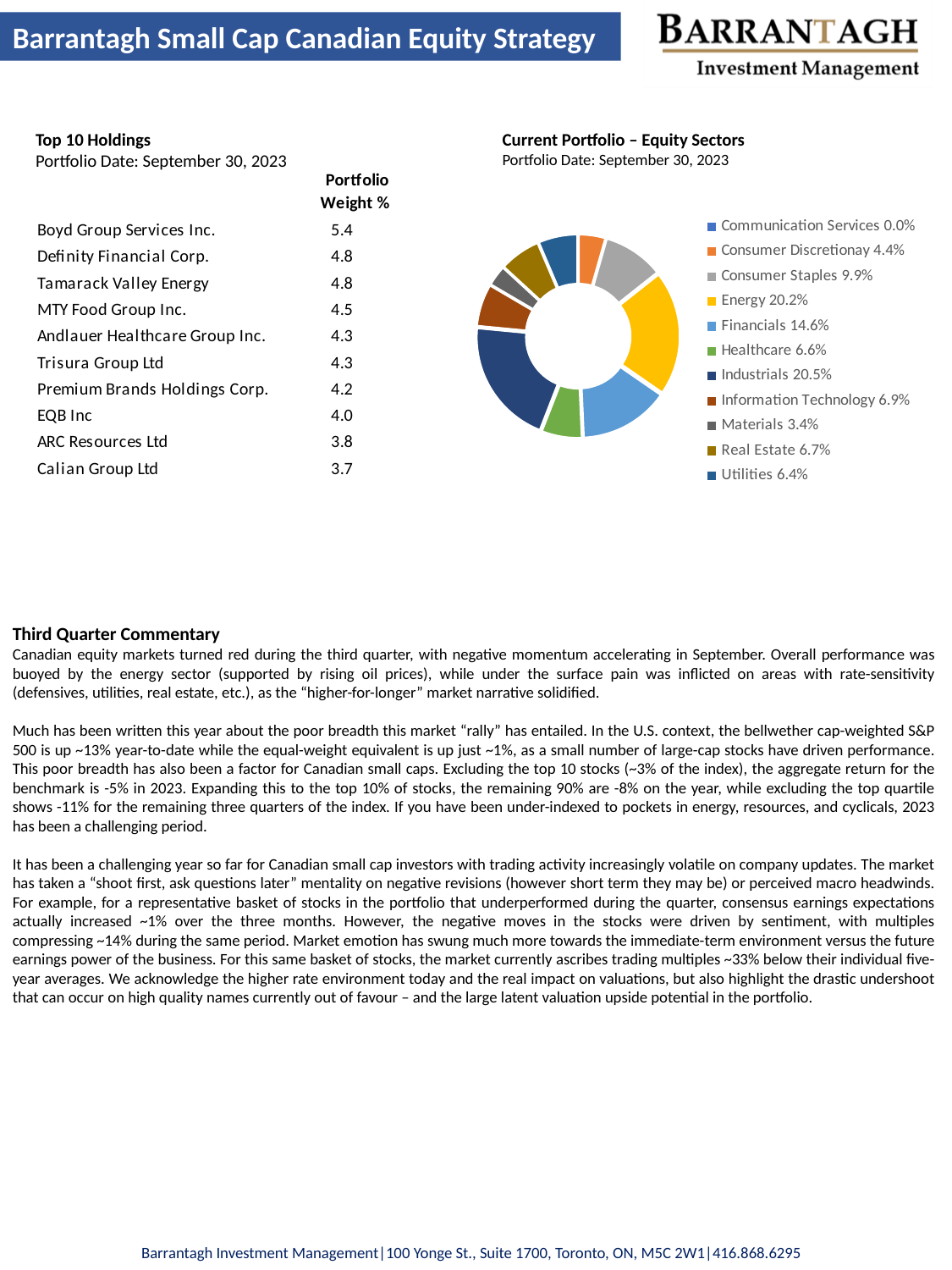
In the 'Current Portfolio – Equity Sectors' chart, what is the share for Energy? 20.2% In the 'Current Portfolio – Equity Sectors' chart, what is the share for Materials? 3.4% In the 'Current Portfolio – Equity Sectors' chart, what is the difference between the Energy share and the Financials share? 5.6% What portfolio date is shown for the 'Current Portfolio – Equity Sectors' chart? September 30, 2023 In the 'Current Portfolio – Equity Sectors' chart, what is the combined share of Industrials and Energy? 40.7% In the 'Current Portfolio – Equity Sectors' chart, which is larger: Consumer Staples or Healthcare? Consumer Staples In the 'Current Portfolio – Equity Sectors' chart, how many sectors are listed in the legend? 11 In the 'Current Portfolio – Equity Sectors' chart, which sector has the smallest share? Communication Services In the 'Current Portfolio – Equity Sectors' chart, what is the share for Real Estate? 6.7% In the 'Current Portfolio – Equity Sectors' chart, which sector has the largest share? Industrials In the 'Current Portfolio – Equity Sectors' chart, what is the share for Financials? 14.6% What kind of chart is used in the 'Current Portfolio – Equity Sectors' chart? Doughnut chart